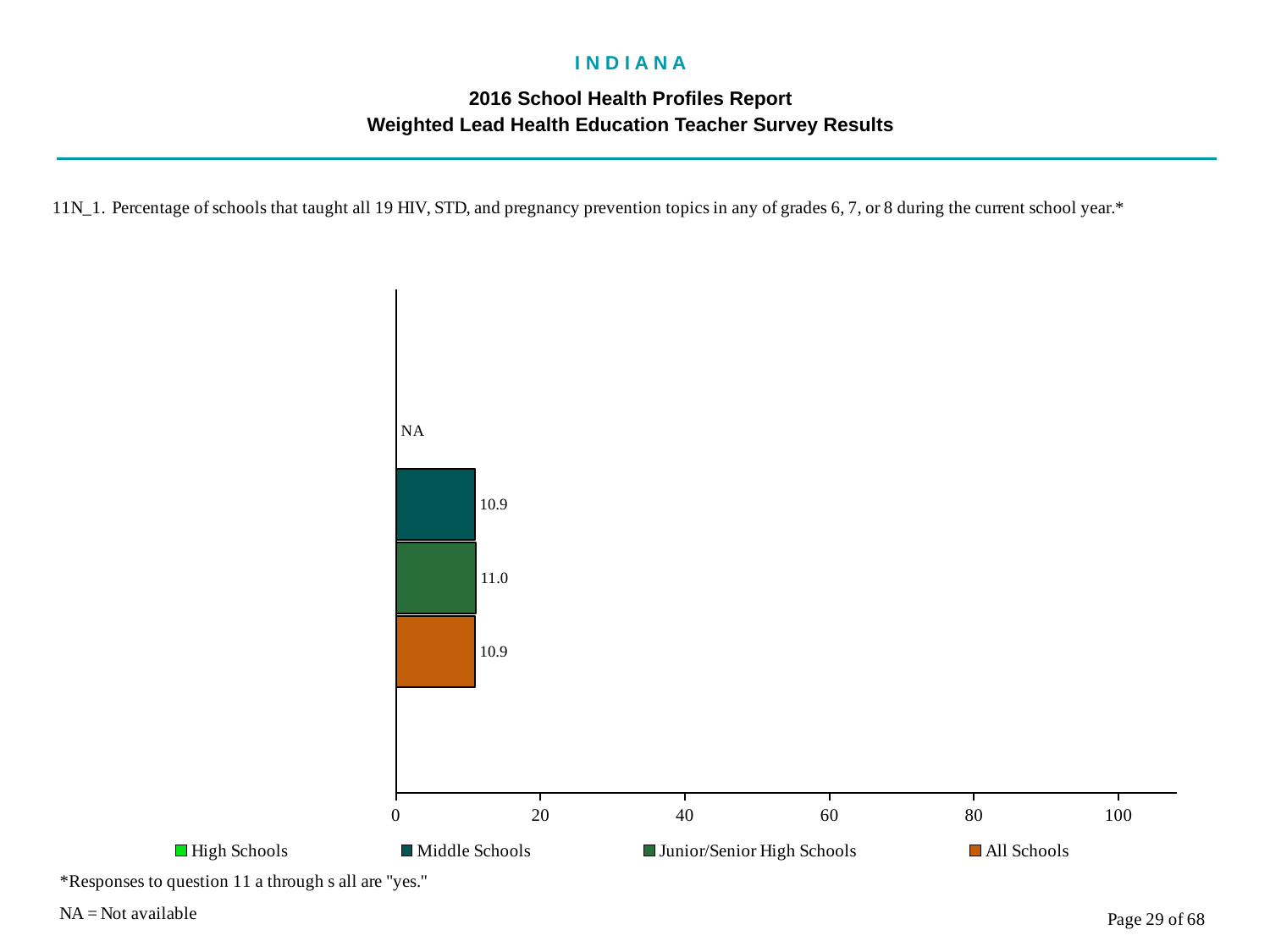
How many bars are actually plotted in the chart? 3 What is shown for High Schools in the chart? NA How many series does the legend list? 4 What is the value for Middle Schools? 10.9 What is the value for All Schools? 10.9 Is the value for All Schools greater or less than 40? less What colour represents All Schools in the legend? orange According to the note on the slide, what does NA stand for? Not available What is the value for Junior/Senior High Schools? 11.0 What is the difference between the values for Junior/Senior High Schools and Middle Schools? 0.1 What kind of chart is shown on the slide? bar chart Is the value for Middle Schools greater or less than 20? less